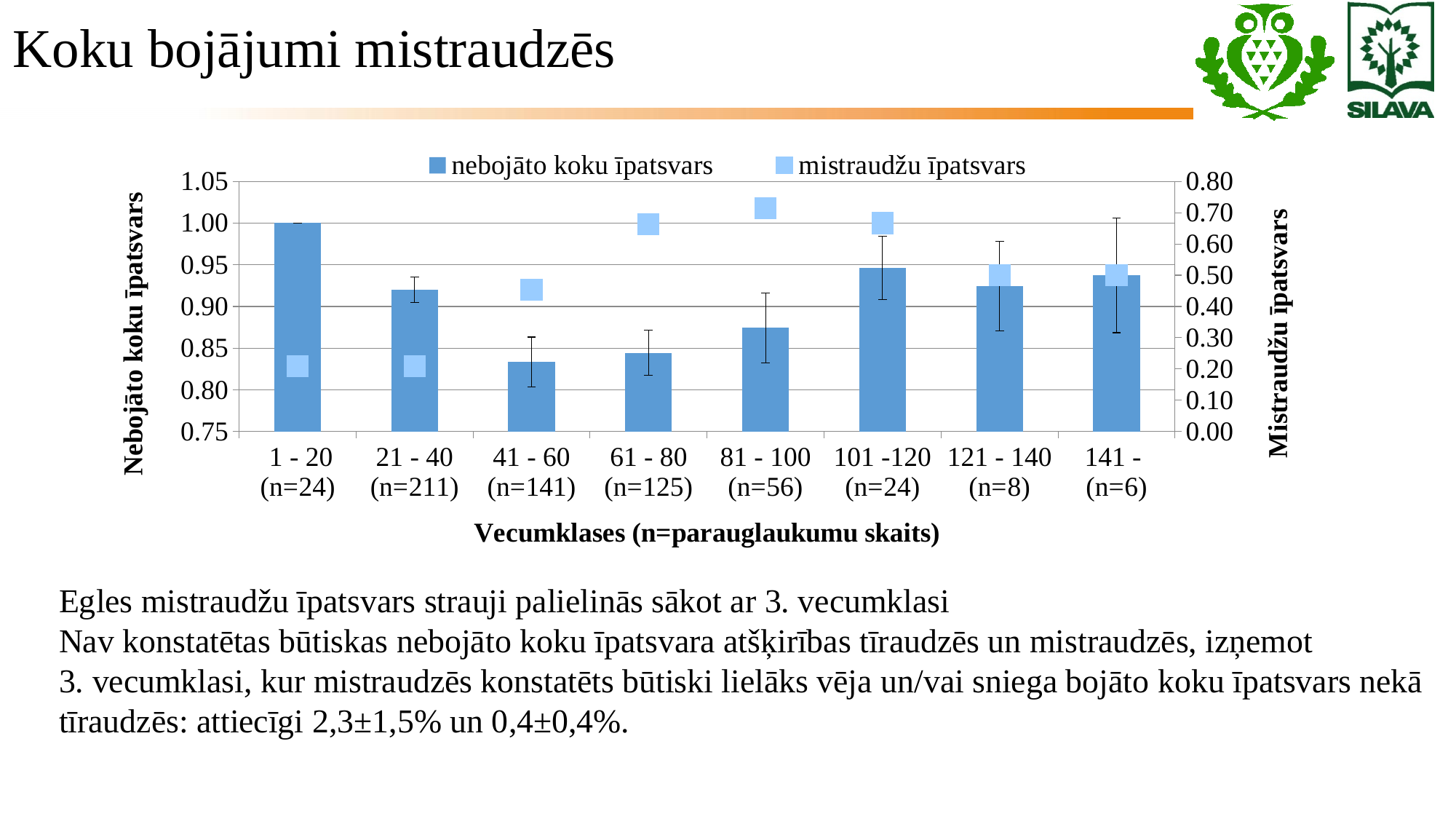
What kind of chart is shown on the slide? bar chart How many age classes (categories) are shown on the x axis? 8 Which age class has the highest marker for mistraudžu īpatsvars? 81 - 100 (n=56) Is the nebojāto koku īpatsvars bar for 41 - 60 (n=141) greater or less than 0.85? less How many series does the legend list? 2 Is the nebojāto koku īpatsvars bar for 101 -120 (n=24) greater or less than 0.90? greater Which has the larger nebojāto koku īpatsvars bar: 21 - 40 (n=211) or 81 - 100 (n=56)? 21 - 40 (n=211) Which age class has the lowest bar for nebojāto koku īpatsvars? 41 - 60 (n=141) Which age class has the highest bar for nebojāto koku īpatsvars? 1 - 20 (n=24) Is the mistraudžu īpatsvars value for 1 - 20 (n=24) greater or less than 0.30? less What is the title of the x axis? Vecumklases (n=parauglaukumu skaits)